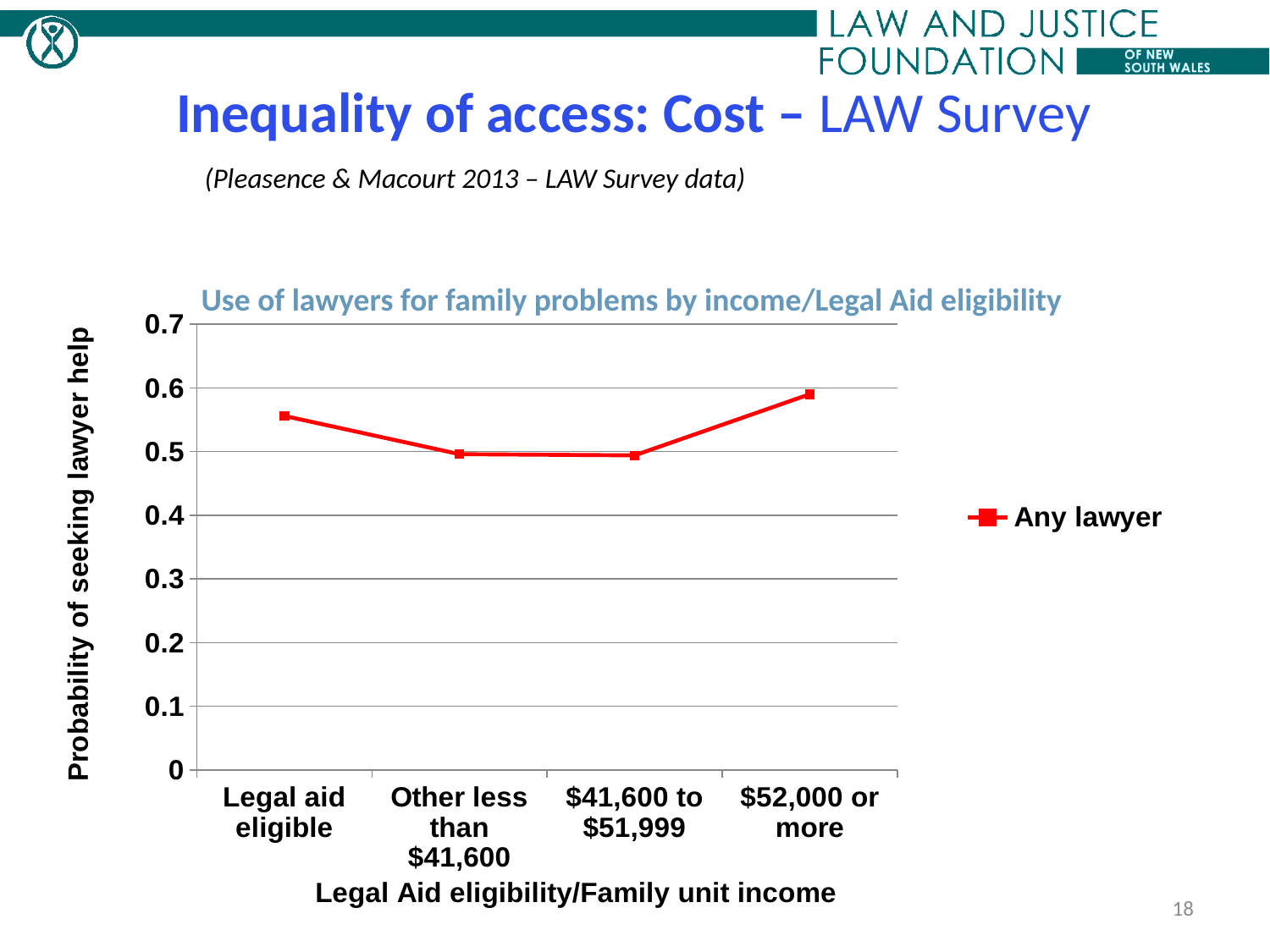
Is the value for $41,600 to $51,999 greater or less than 0.4? greater Is the value for Other less than $41,600 greater or less than 0.6? less Is the value for $52,000 or more greater or less than 0.5? greater What is the title of the chart? Use of lawyers for family problems by income/Legal Aid eligibility Which is larger: the value for Legal aid eligible or the value for $41,600 to $51,999? Legal aid eligible Which category has the highest probability of seeking lawyer help? $52,000 or more What kind of chart is shown on the slide? Line chart How many categories are plotted along the x axis of the chart? 4 How many series does the chart's legend list? 1 What series name is shown in the chart's legend? Any lawyer Does the line rise or fall between Legal aid eligible and Other less than $41,600? Falls